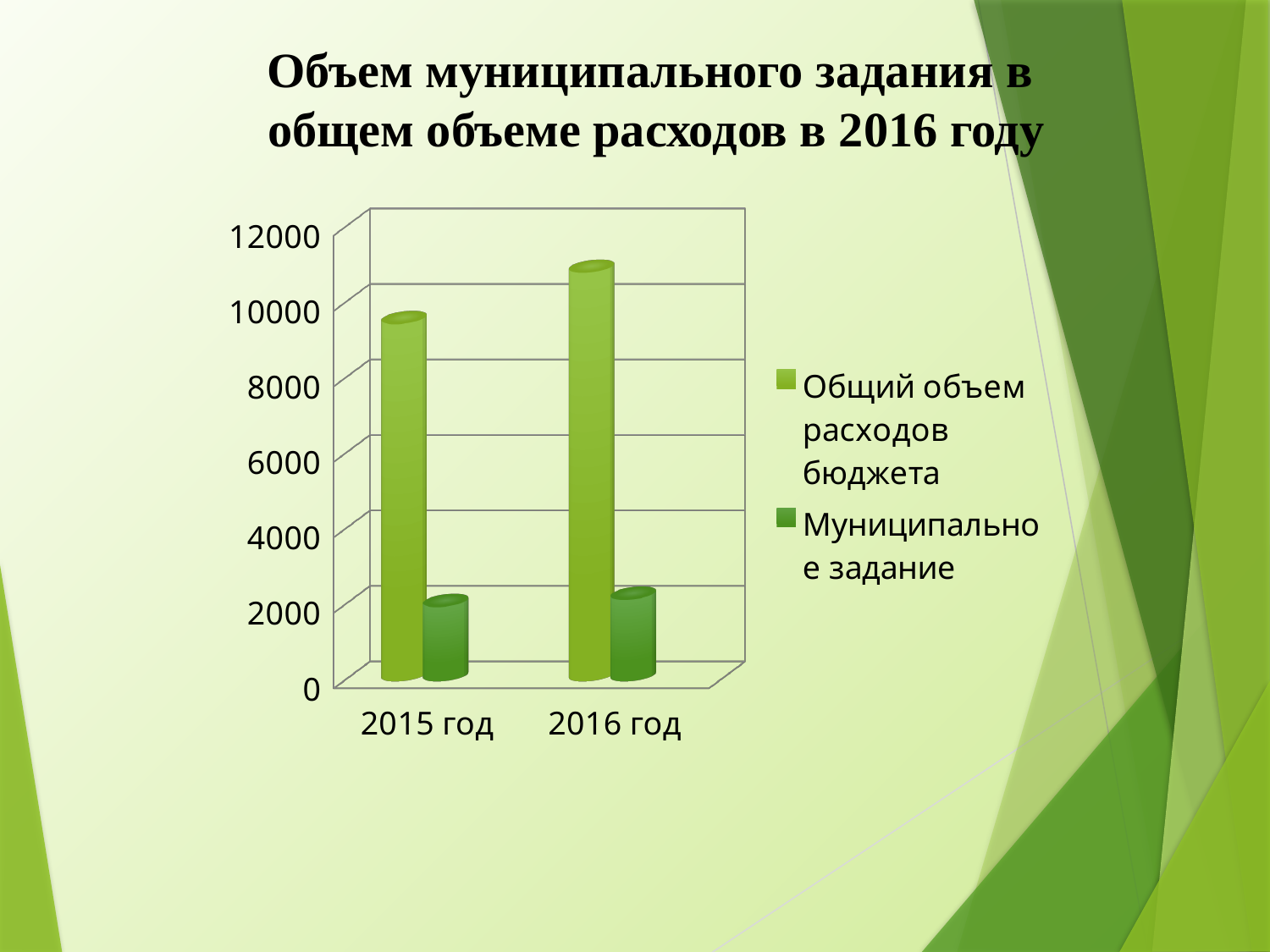
Which year has the higher value for Общий объем расходов бюджета? 2016 год Is the value for Общий объем расходов бюджета in 2016 год greater or less than 10000? greater How many categories are shown on the x axis? 2 Does the value for Общий объем расходов бюджета rise or fall from 2015 год to 2016 год? rise Is the value for Общий объем расходов бюджета in 2016 год greater or less than 12000? less In 2015 год, which is larger: Общий объем расходов бюджета or Муниципальное задание? Общий объем расходов бюджета What is the title of the chart on the slide? Объем муниципального задания в общем объеме расходов в 2016 году How many series does the legend list? 2 Which series is shown in the darker green colour? Муниципальное задание What kind of chart is shown on the slide? bar chart Is the value for Муниципальное задание in 2016 год greater or less than 4000? less